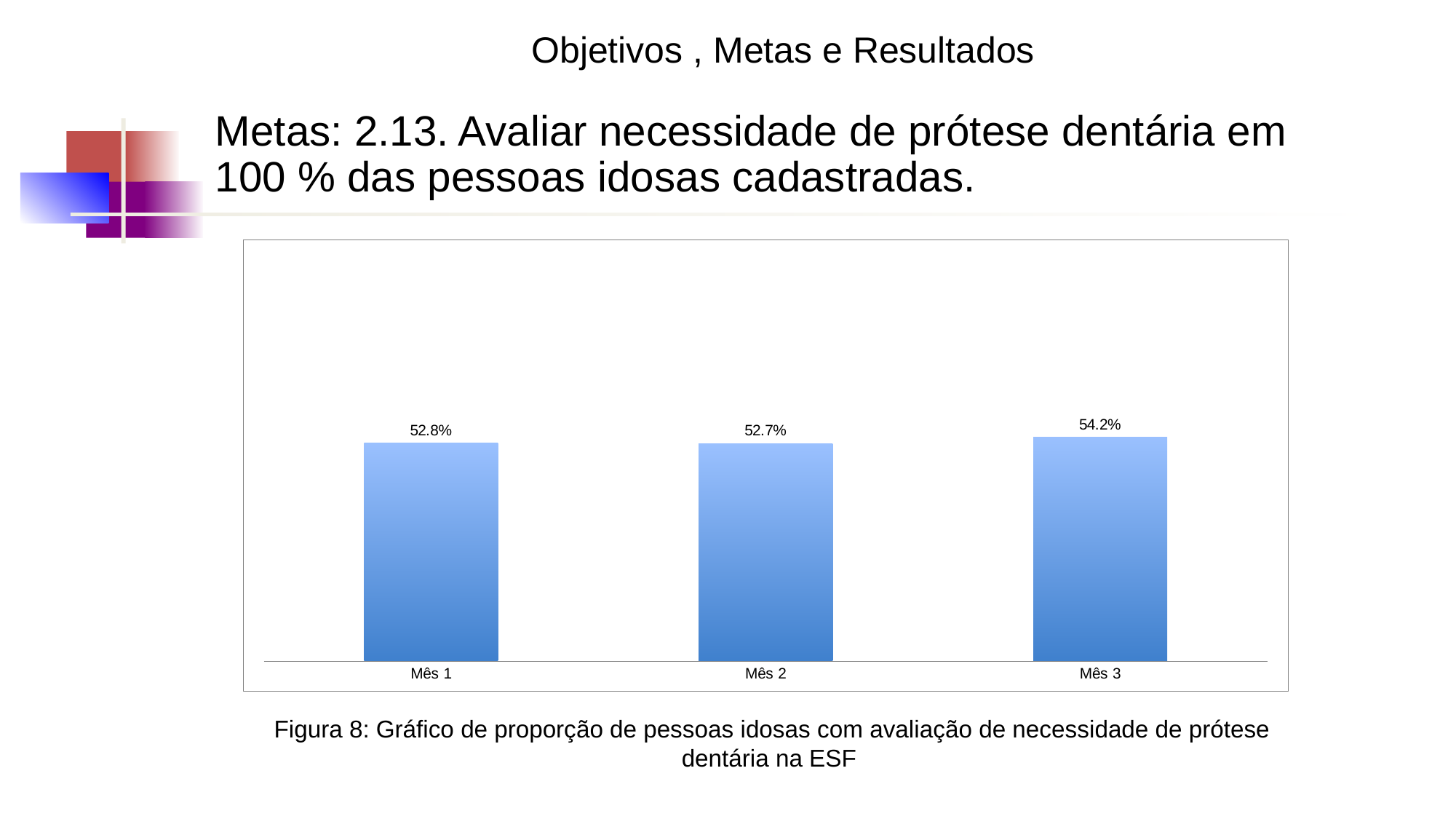
What is the value for Mês 3? 54.2% Is the value for Mês 3 higher or lower than the value for Mês 1? Higher Which is larger, the value for Mês 3 or the value for Mês 1? Mês 3 How many months are shown on the x axis? 3 What is the value for Mês 2? 52.7% Which is larger, the value for Mês 2 or the value for Mês 3? Mês 3 What kind of chart is shown on the slide? Bar chart What figure number is given in the caption below the chart? Figura 8 What is the difference between the values for Mês 3 and Mês 1? 1.4 percentage points What is the difference between the values for Mês 3 and Mês 2? 1.5 percentage points Which month has the highest value? Mês 3 What is the value for Mês 1? 52.8%